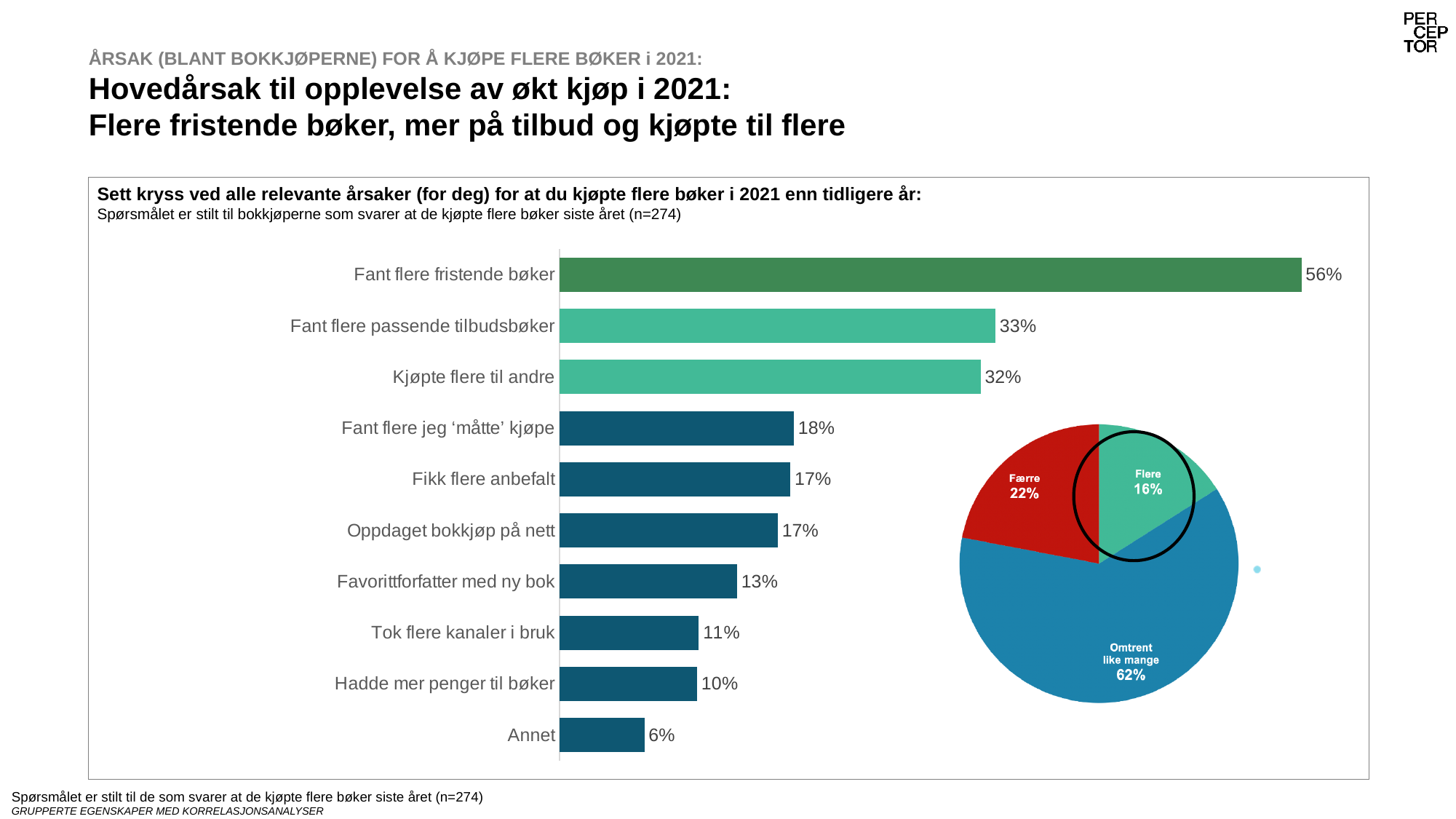
In the pie chart, what share does 'Omtrent like mange' have? 62% How many categories does the bar chart show? 10 What kind of chart is the chart on the left side of the slide? Bar chart How many slices does the pie chart have? 3 In the bar chart, which category has the highest value? Fant flere fristende bøker In the bar chart, what is the value for 'Hadde mer penger til bøker'? 10% In the bar chart, which category has the lowest value? Annet In the bar chart, what is the difference between 'Fant flere passende tilbudsbøker' and 'Kjøpte flere til andre'? 1% In the bar chart, what is the value for 'Fant flere fristende bøker'? 56% In the bar chart, which is larger: 'Favorittforfatter med ny bok' or 'Tok flere kanaler i bruk'? Favorittforfatter med ny bok In the pie chart, what is the value for 'Færre'? 22% In the pie chart, which slice is circled? Flere 16%